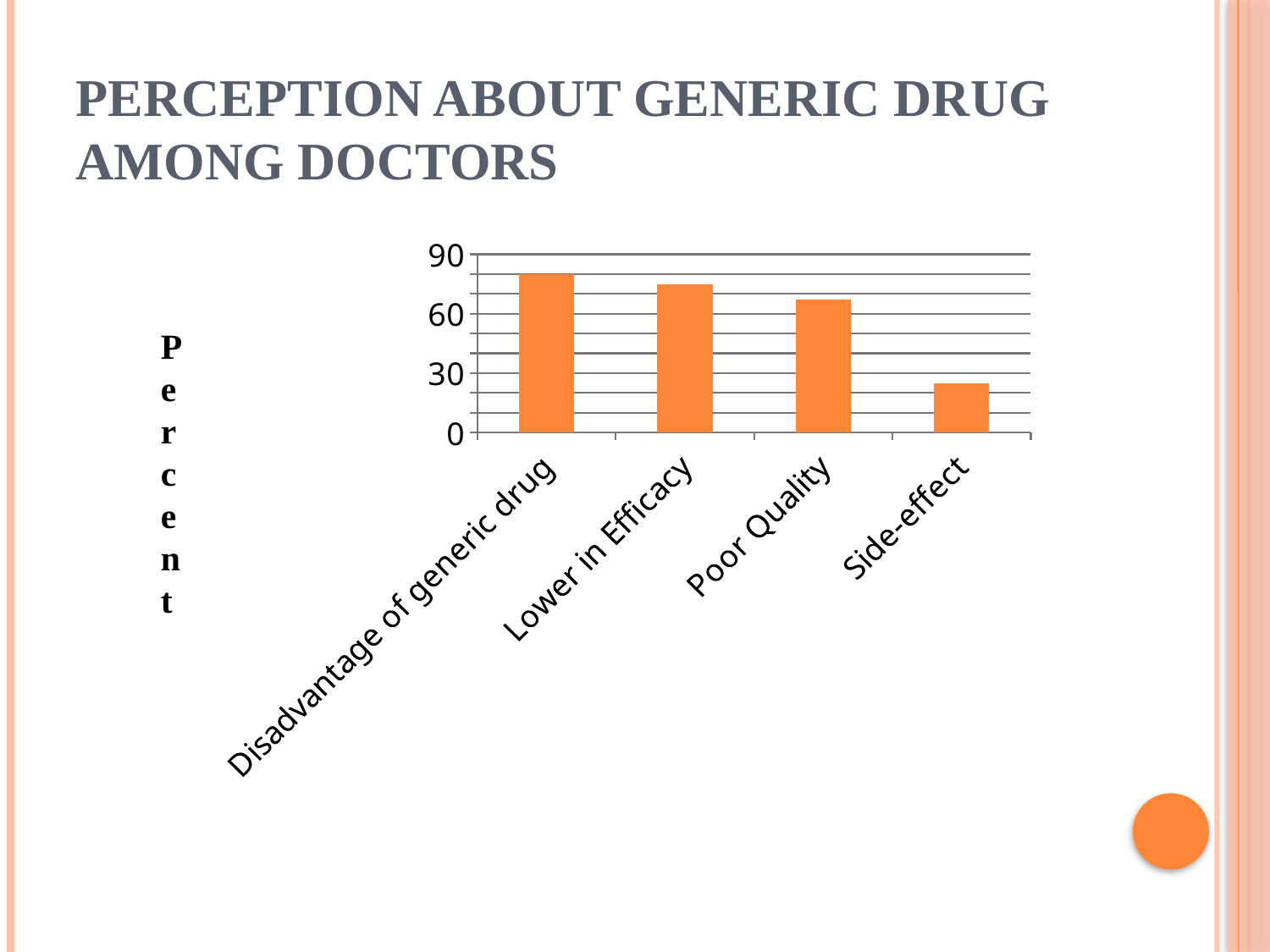
Do the values rise or fall from left to right across the categories? fall Is the value for Side-effect greater or less than 30? less Is the value for Disadvantage of generic drug greater or less than 60? greater Which is larger, the value for Disadvantage of generic drug or the value for Poor Quality? Disadvantage of generic drug What is the label on the vertical axis of the chart? Percent What kind of chart is shown on the slide? bar chart How many categories are plotted in the chart? 4 Is the value for Poor Quality greater or less than 60? greater Which category has the highest value? Disadvantage of generic drug Which category has the lowest value? Side-effect Which is larger, the value for Poor Quality or the value for Side-effect? Poor Quality